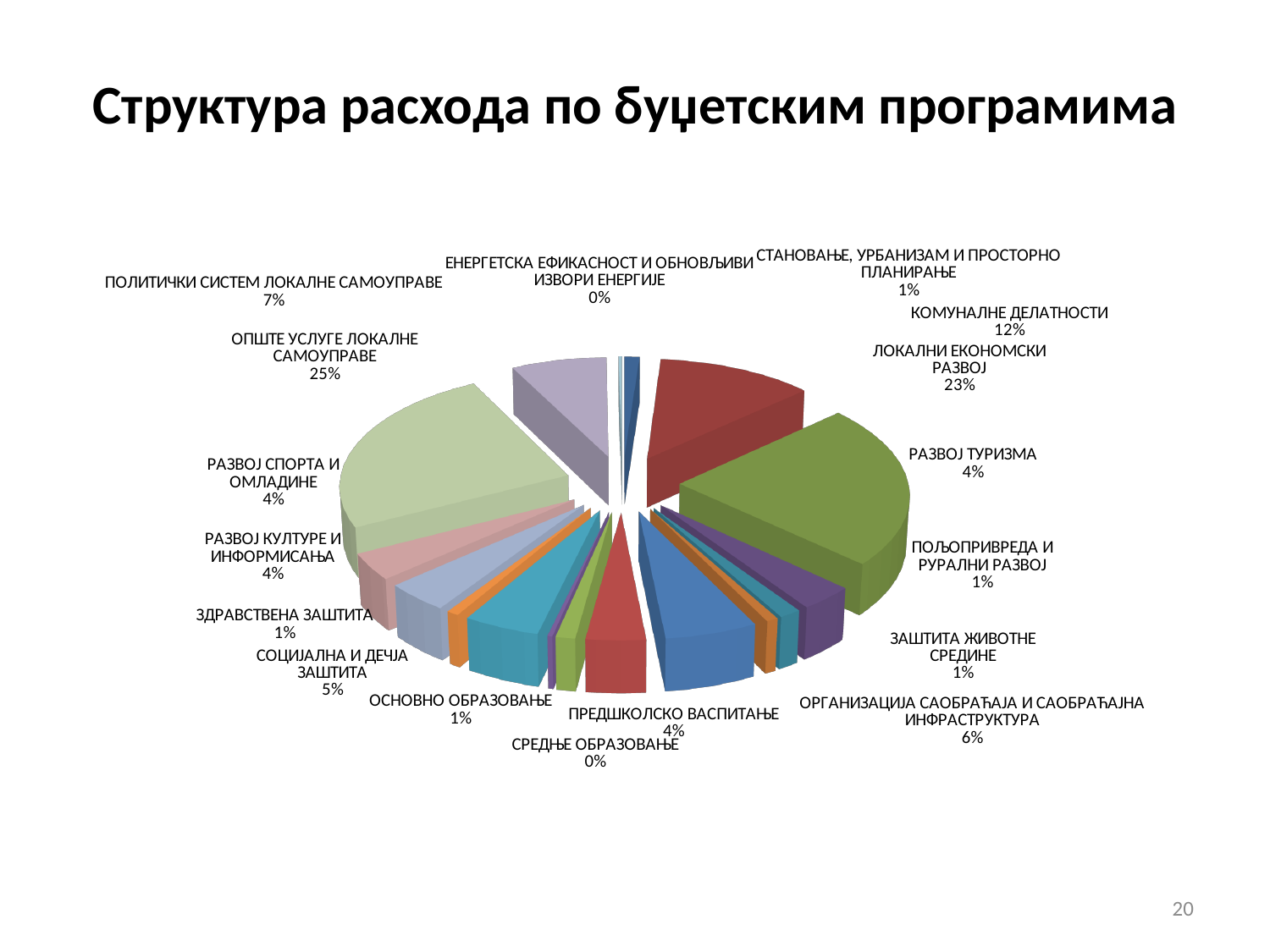
How many budget programmes (slices) are labelled in the pie chart? 17 What is the title of the chart on the slide? Структура расхода по буџетским програмима What percentage is shown for СОЦИЈАЛНА И ДЕЧЈА ЗАШТИТА? 5% What percentage is shown for ЛОКАЛНИ ЕКОНОМСКИ РАЗВОЈ? 23% What is the difference in percentage points between ОПШТЕ УСЛУГЕ ЛОКАЛНЕ САМОУПРАВЕ and ЛОКАЛНИ ЕКОНОМСКИ РАЗВОЈ? 2 percentage points What kind of chart is shown on the slide? pie chart Which has a larger share, КОМУНАЛНЕ ДЕЛАТНОСТИ or ПРЕДШКОЛСКО ВАСПИТАЊЕ? КОМУНАЛНЕ ДЕЛАТНОСТИ What share of expenditure goes to ОПШТЕ УСЛУГЕ ЛОКАЛНЕ САМОУПРАВЕ? 25% Which budget programme has the largest share of expenditure? ОПШТЕ УСЛУГЕ ЛОКАЛНЕ САМОУПРАВЕ What percentage is shown for КОМУНАЛНЕ ДЕЛАТНОСТИ? 12% What percentage is shown for ОРГАНИЗАЦИЈА САОБРАЋАЈА И САОБРАЋАЈНА ИНФРАСТРУКТУРА? 6% What percentage is shown for ПОЛИТИЧКИ СИСТЕМ ЛОКАЛНЕ САМОУПРАВЕ? 7%